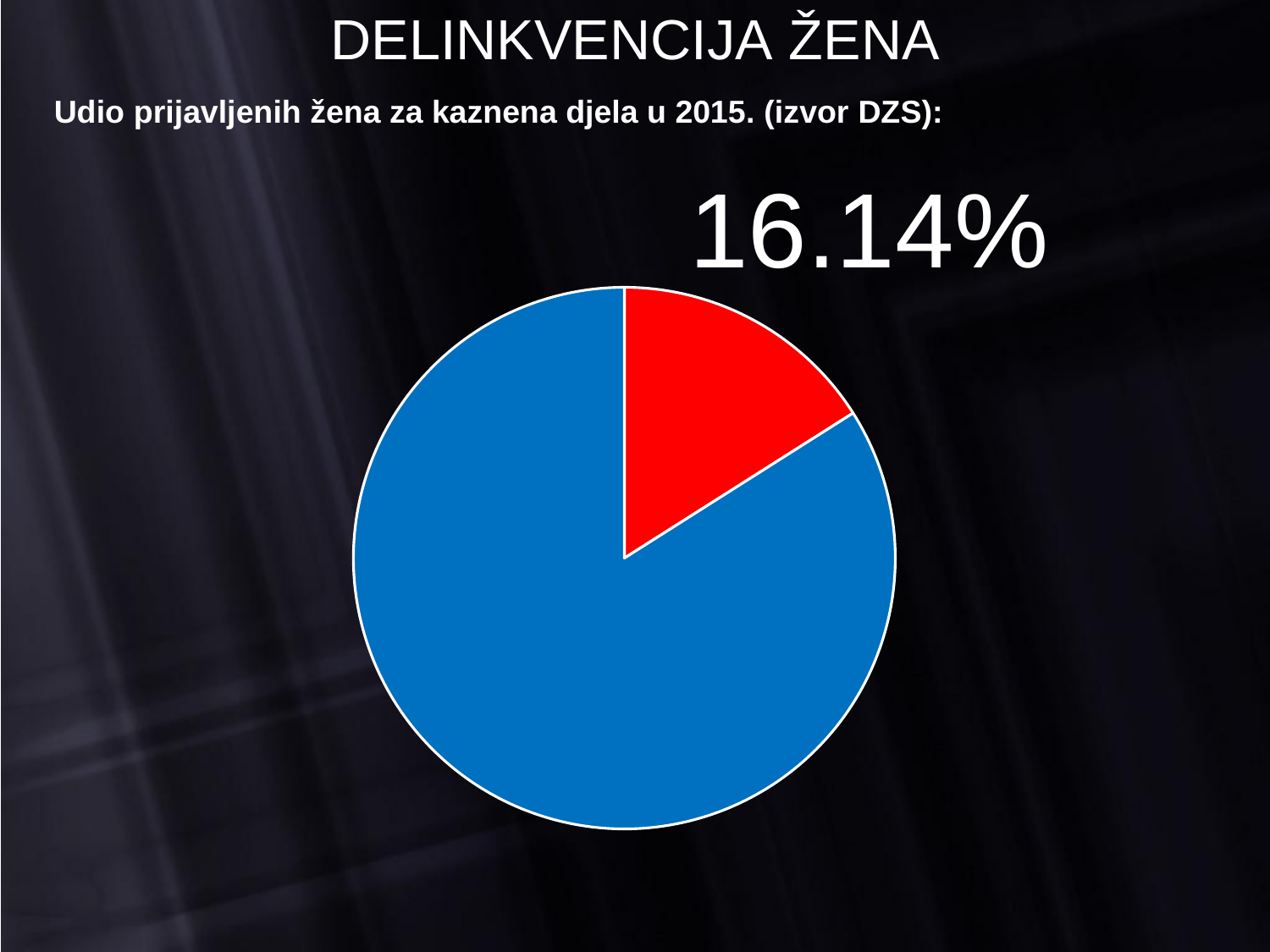
What kind of chart is shown on the slide? Pie chart What percentage is printed as the data label on the pie chart? 16.14% What share of the pie does the red slice represent? 16.14% What colour is the slice labelled 16.14%? Red Which slice of the pie chart is the smallest? The red slice What is the title at the top of the slide containing the pie chart? DELINKVENCIJA ŽENA Which slice of the pie chart is larger, the red one or the blue one? Blue Which slice of the pie chart is the largest? The blue slice How many slices does the pie chart have? 2 What share of the pie does the blue slice represent, given the red slice is 16.14%? 83.86%